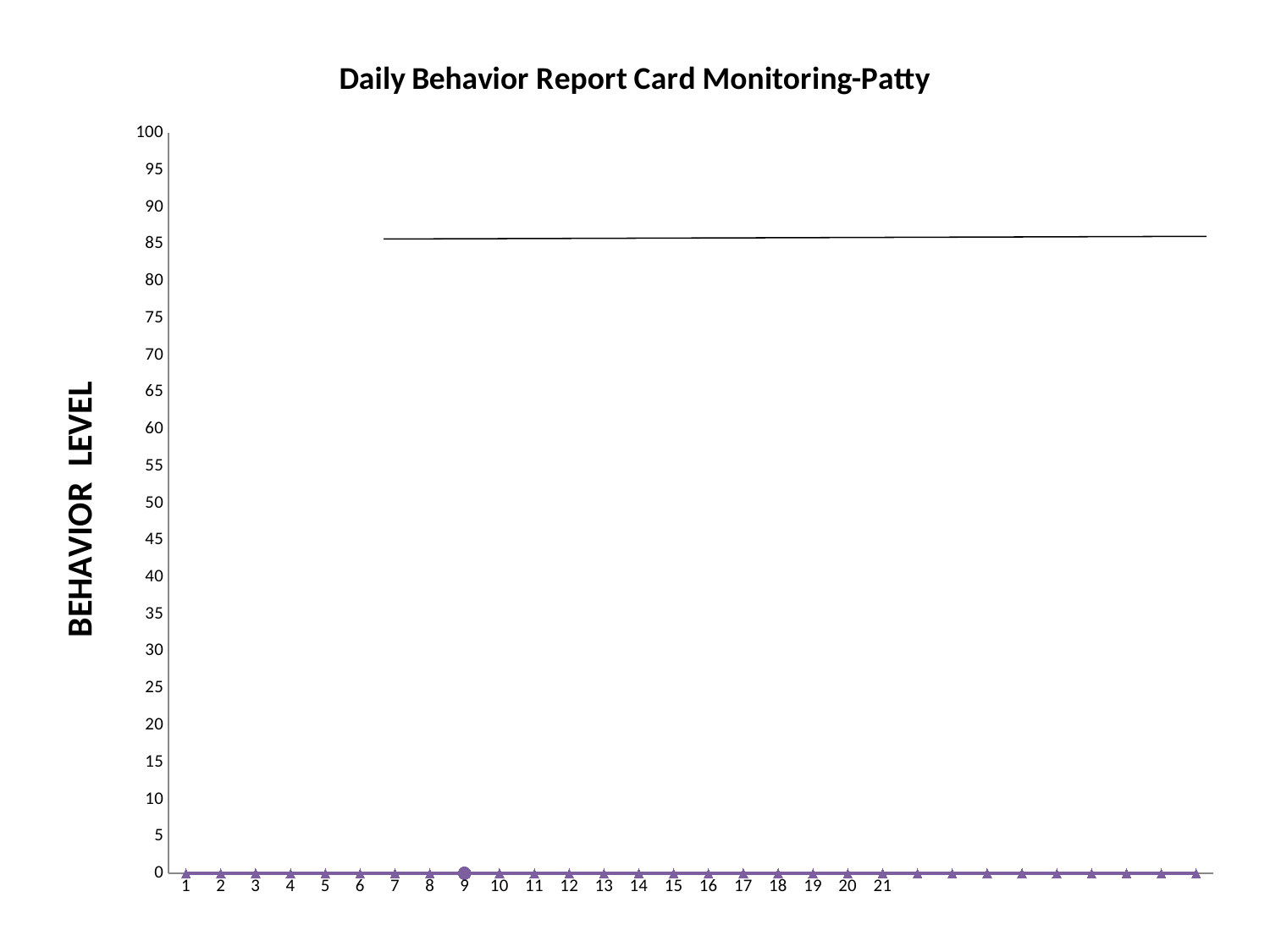
What is the title of the chart? Daily Behavior Report Card Monitoring-Patty What is the highest value shown on the vertical axis? 100 What is the value of the purple marked series at category 3? 0 Is the black horizontal line greater or less than 80 on the behavior level axis? greater Is the black horizontal line greater or less than 90 on the behavior level axis? less What is the value of the purple marked series at category 15? 0 How many numbered categories are labeled along the x axis? 21 Does the purple marked series rise, fall, or stay flat across the x axis? stays flat Which is higher: the black horizontal line or the purple marked series? the black horizontal line What is the label on the vertical axis of the chart? BEHAVIOR LEVEL Is the value of the purple marked series at category 10 greater or less than 50? less What kind of chart is shown on the slide? line chart